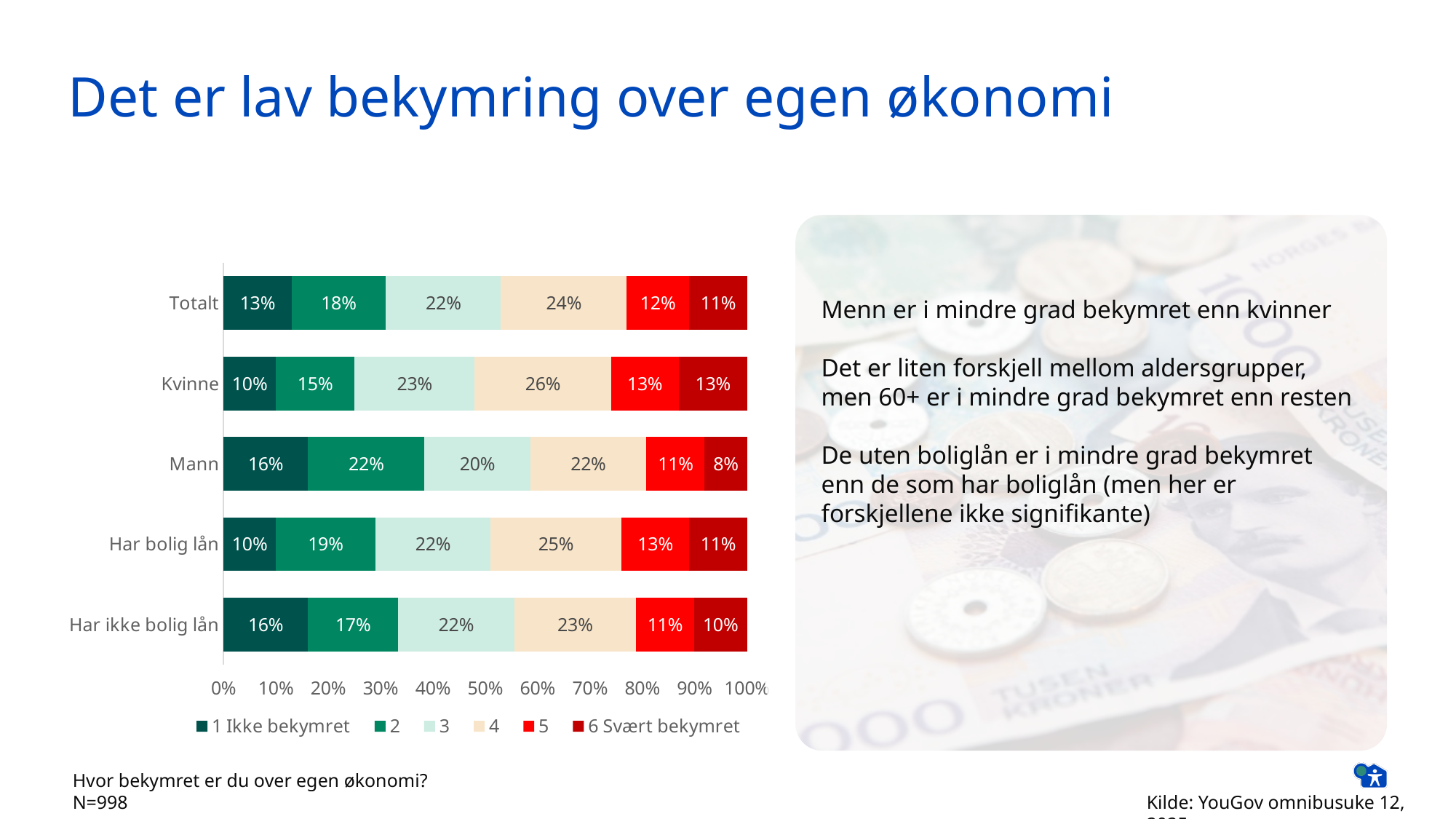
What percentage of Mann answered "6 Svært bekymret"? 8% Which category has the highest share for "6 Svært bekymret"? Kvinne Which category has the lowest share for "6 Svært bekymret"? Mann What is the value for Kvinne in the "4" series? 26% What percentage of the Totalt group answered "1 Ikke bekymret"? 13% How many percentage points higher is the "2" value for Mann than for Kvinne? 7 percentage points How many series does the legend list? 6 How many categories (bars) are shown on the chart? 5 What is the legend label for the dark red series? 6 Svært bekymret What is the combined share of "1 Ikke bekymret" and "2" for the Totalt group? 31% Which has a larger value in the "4" series, Kvinne or Mann? Kvinne What kind of chart is shown on the slide? Stacked bar chart